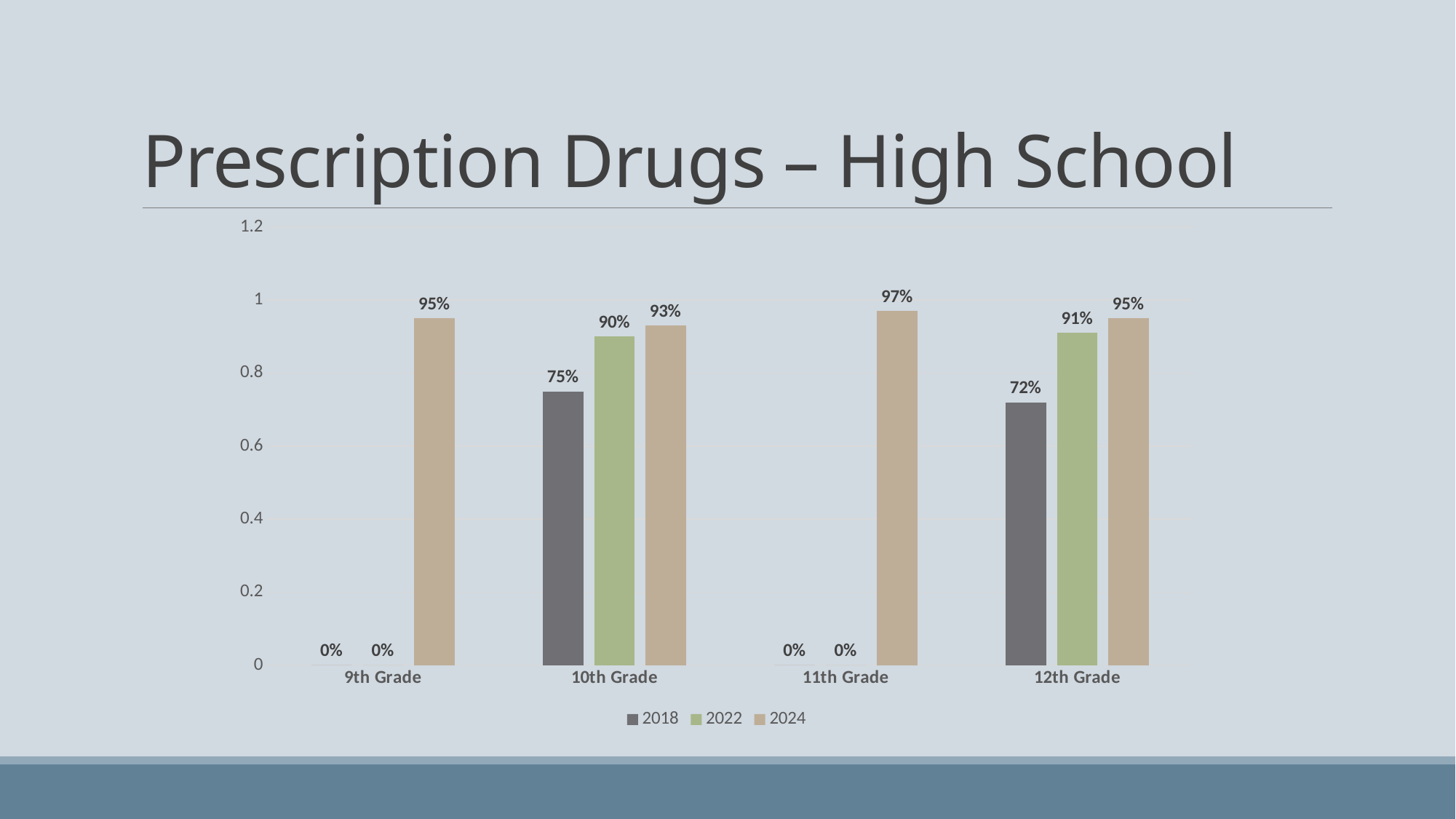
What is the title of the slide? Prescription Drugs – High School Which grade has the lowest 2018 value among those with a non-zero 2018 bar? 12th Grade How many grade categories are shown on the x axis? 4 Which grade has the highest 2024 value? 11th Grade What is the difference between the 2024 and 2018 values for 10th Grade? 18% Which is larger for 12th Grade, the 2022 value or the 2024 value? 2024 How many series does the legend list? 3 What is the value for 2024 for 11th Grade? 97% What is the value for 2022 for 12th Grade? 91% What is the value for 2024 for 9th Grade? 95% What is the value for 2018 for 10th Grade? 75% What kind of chart is shown on the slide? Bar chart